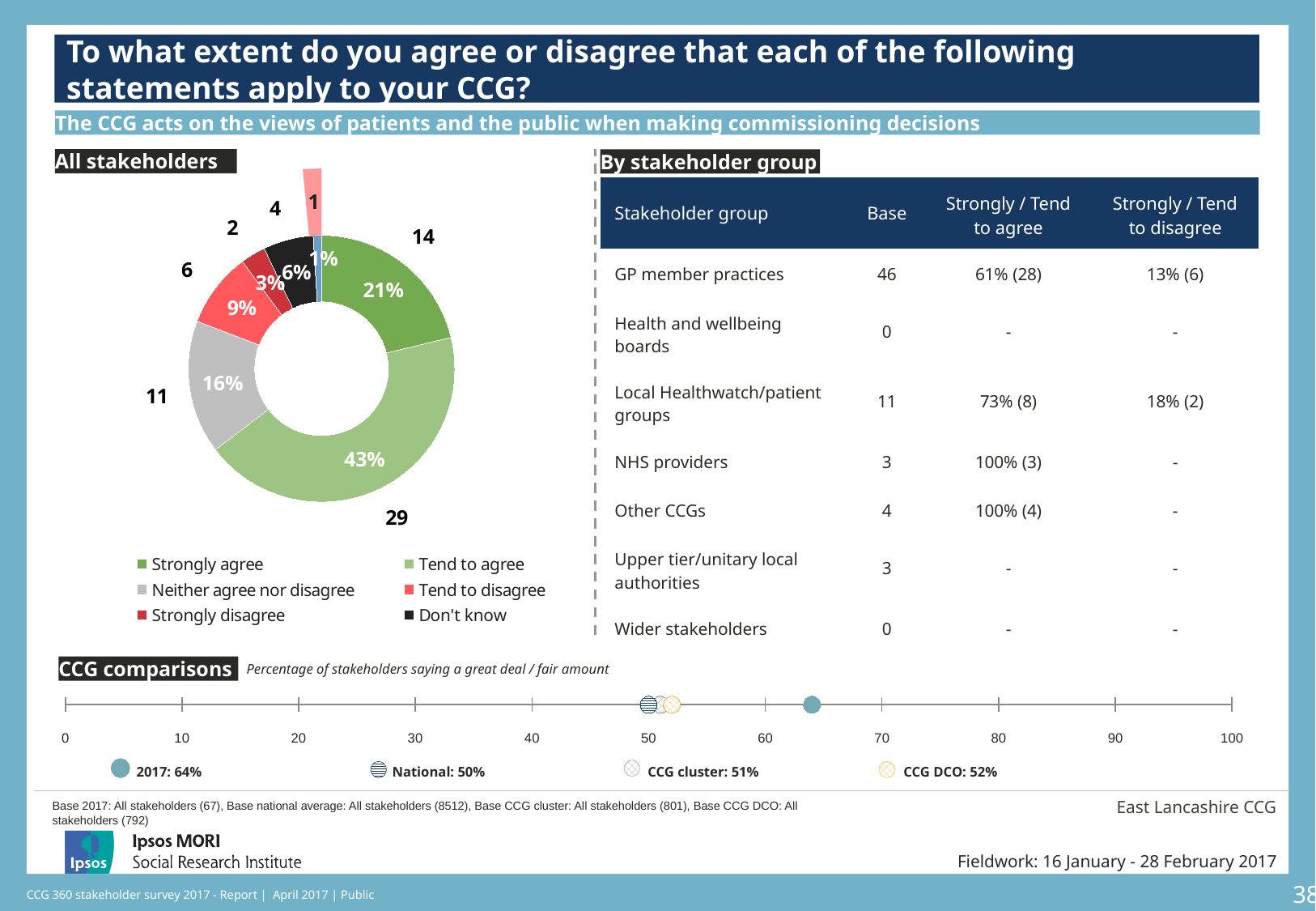
In the 'All stakeholders' chart, which response has the largest share? Tend to agree How many entries does the legend of the 'All stakeholders' chart list? 6 In the 'All stakeholders' chart, what percentage of stakeholders 'Tend to agree'? 43% In the 'All stakeholders' chart, which is larger: 'Tend to disagree' or 'Strongly disagree'? Tend to disagree In the 'All stakeholders' chart, how many stakeholders 'Tend to agree'? 29 In the 'All stakeholders' chart, what percentage of stakeholders 'Strongly agree'? 21% In the 'CCG comparisons' chart, what is the National value? 50% In the 'CCG comparisons' chart, is the 2017 value greater or less than 60? greater In the 'CCG comparisons' chart, what is the 2017 value? 64% In the 'All stakeholders' chart, what percentage of stakeholders 'Neither agree nor disagree'? 16% In the 'All stakeholders' chart, what is the difference in percentage points between 'Tend to agree' and 'Strongly agree'? 22 What kind of chart is the 'All stakeholders' chart? doughnut chart